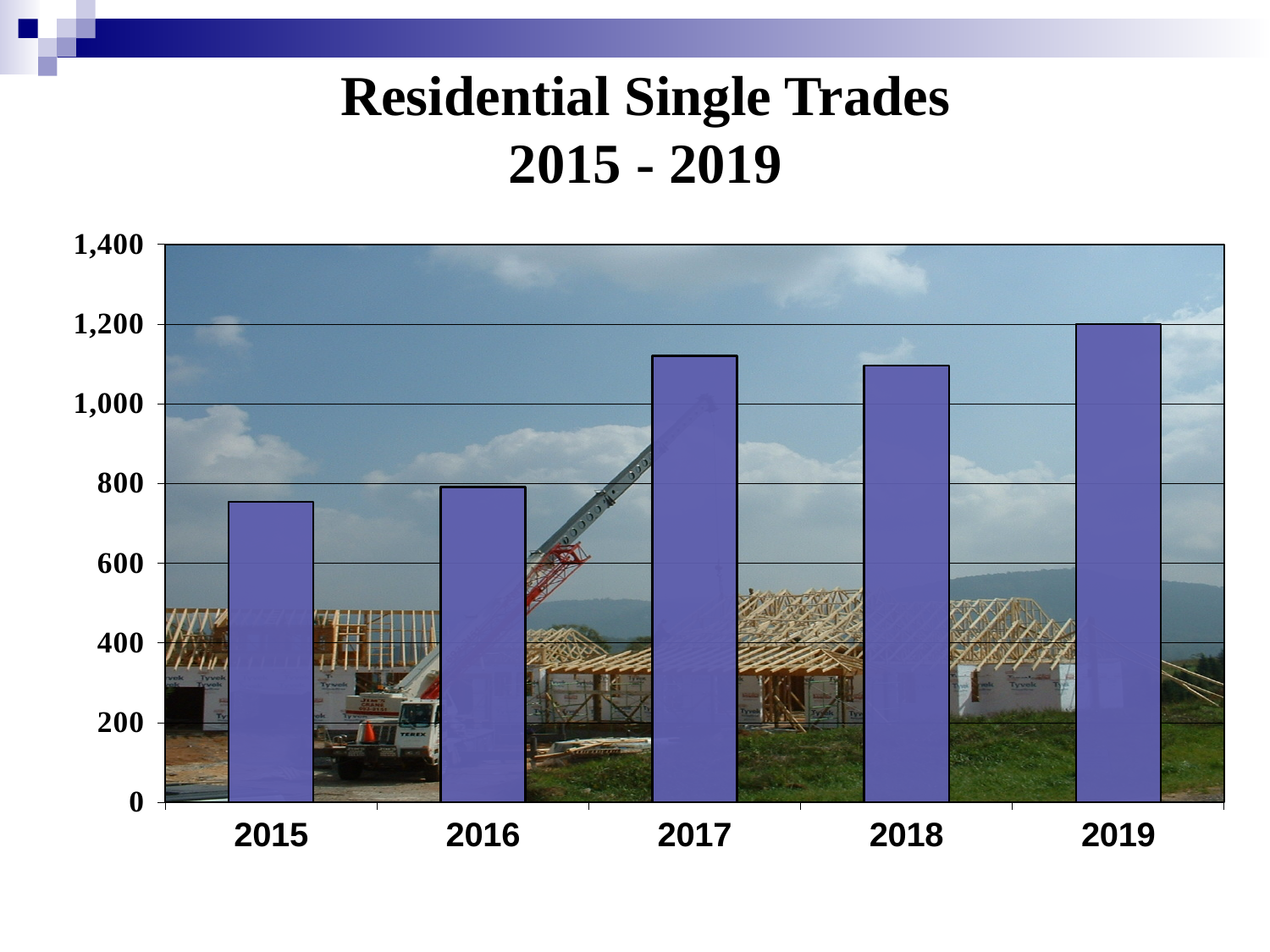
Do the values generally rise or fall from 2015 to 2019? rise Which year has the lowest value in the chart? 2015 Which is larger, the value for 2017 or the value for 2016? 2017 Is the value for 2015 greater or less than 600? greater What is the title of the chart? Residential Single Trades 2015 - 2019 How many years are shown on the x axis of the chart? 5 Is the value for 2015 greater or less than 800? less What type of chart is shown on the slide? Bar chart Which year has the highest value in the chart? 2019 Is the value for 2018 greater or less than 1,200? less